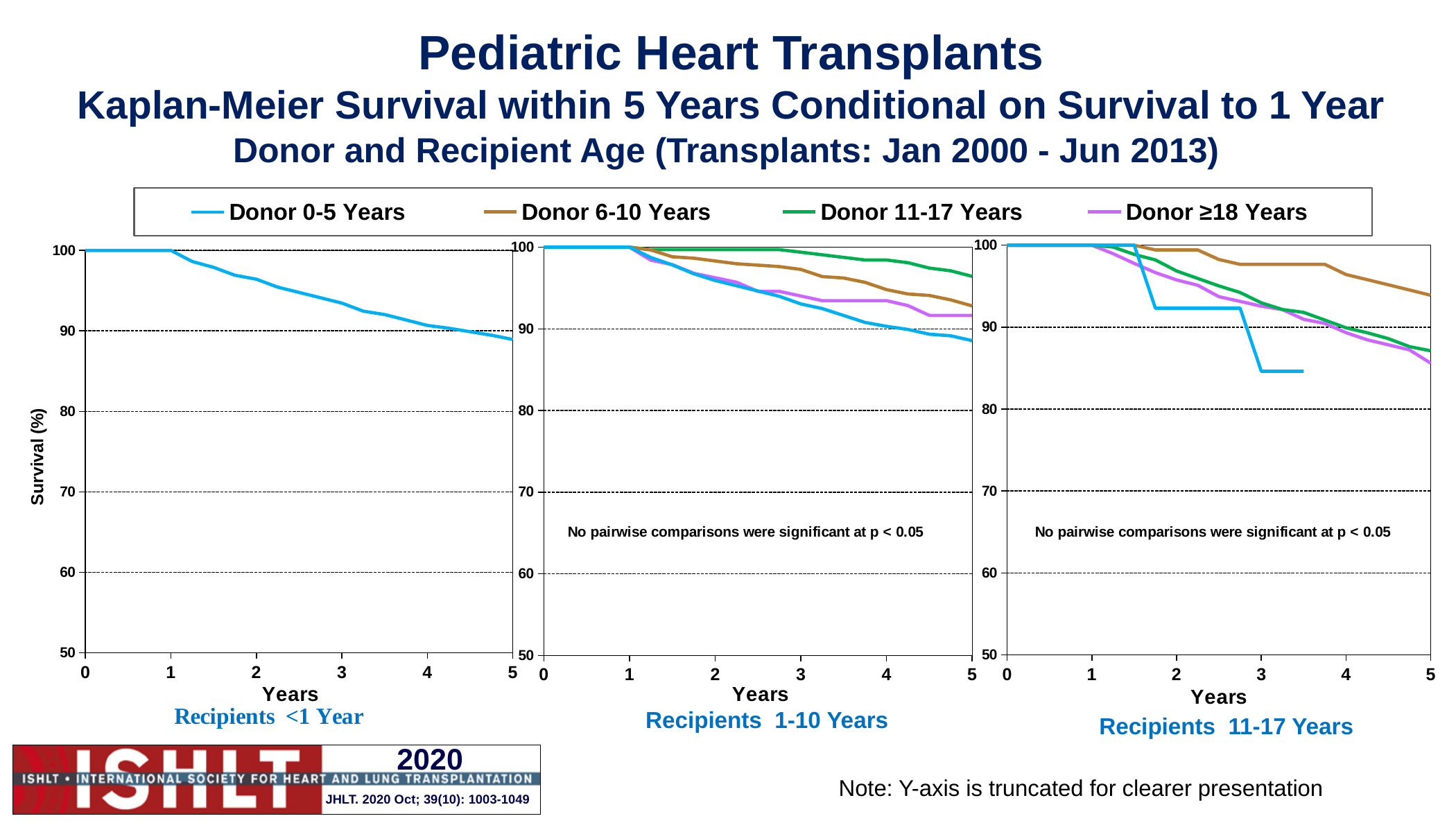
In the 'Recipients <1 Year' chart, does survival rise or fall as years increase? Fall In the 'Recipients 11-17 Years' chart, is the survival for Donor ≥18 Years at 5 years greater or less than 90? less What is the label on the y-axis of the charts? Survival (%) In the 'Recipients 1-10 Years' chart, is the survival for Donor 11-17 Years at 5 years greater or less than 90? greater In the 'Recipients 11-17 Years' chart, which is higher at 3 years: Donor 0-5 Years or Donor 6-10 Years? Donor 6-10 Years Which colour represents Donor 0-5 Years in the legend? Blue In the 'Recipients <1 Year' chart, is the survival value at 5 years greater or less than 90? less How many donor age groups does the legend list? 4 In the 'Recipients 11-17 Years' chart, which donor age group has the highest survival at 5 years? Donor 6-10 Years In the 'Recipients 1-10 Years' chart, which donor age group has the lowest survival at 5 years? Donor 0-5 Years What kind of chart is used in the 'Recipients <1 Year' panel? Line chart In the 'Recipients 1-10 Years' chart, which donor age group has the highest survival at 5 years? Donor 11-17 Years